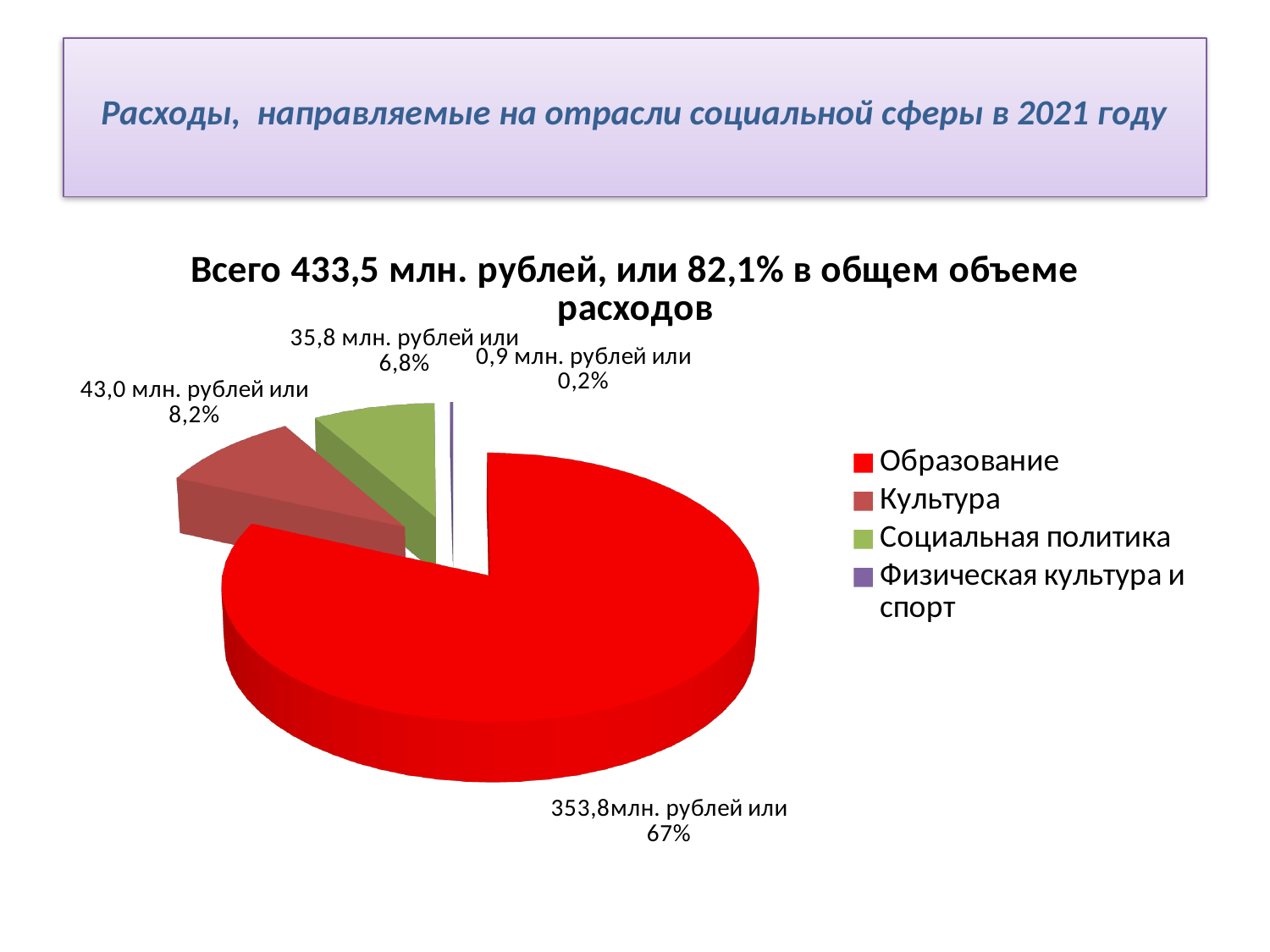
What amount is printed for the Физическая культура и спорт slice? 0,9 млн. рублей What amount is printed for the Культура slice? 43,0 млн. рублей What percentage is printed for the Образование slice? 67% What total amount is stated in the chart title? 433,5 млн. рублей What percentage is printed for the Социальная политика slice? 6,8% What kind of chart is shown on the slide? Pie chart What is the difference between the amounts for Культура and Социальная политика? 7,2 млн. рублей What amount is printed for the Образование slice? 353,8 млн. рублей Which category has the largest slice of the pie? Образование Which is larger, the amount for Культура or the amount for Социальная политика? Культура How many categories does the legend of the pie chart list? 4 Which category has the smallest slice of the pie? Физическая культура и спорт